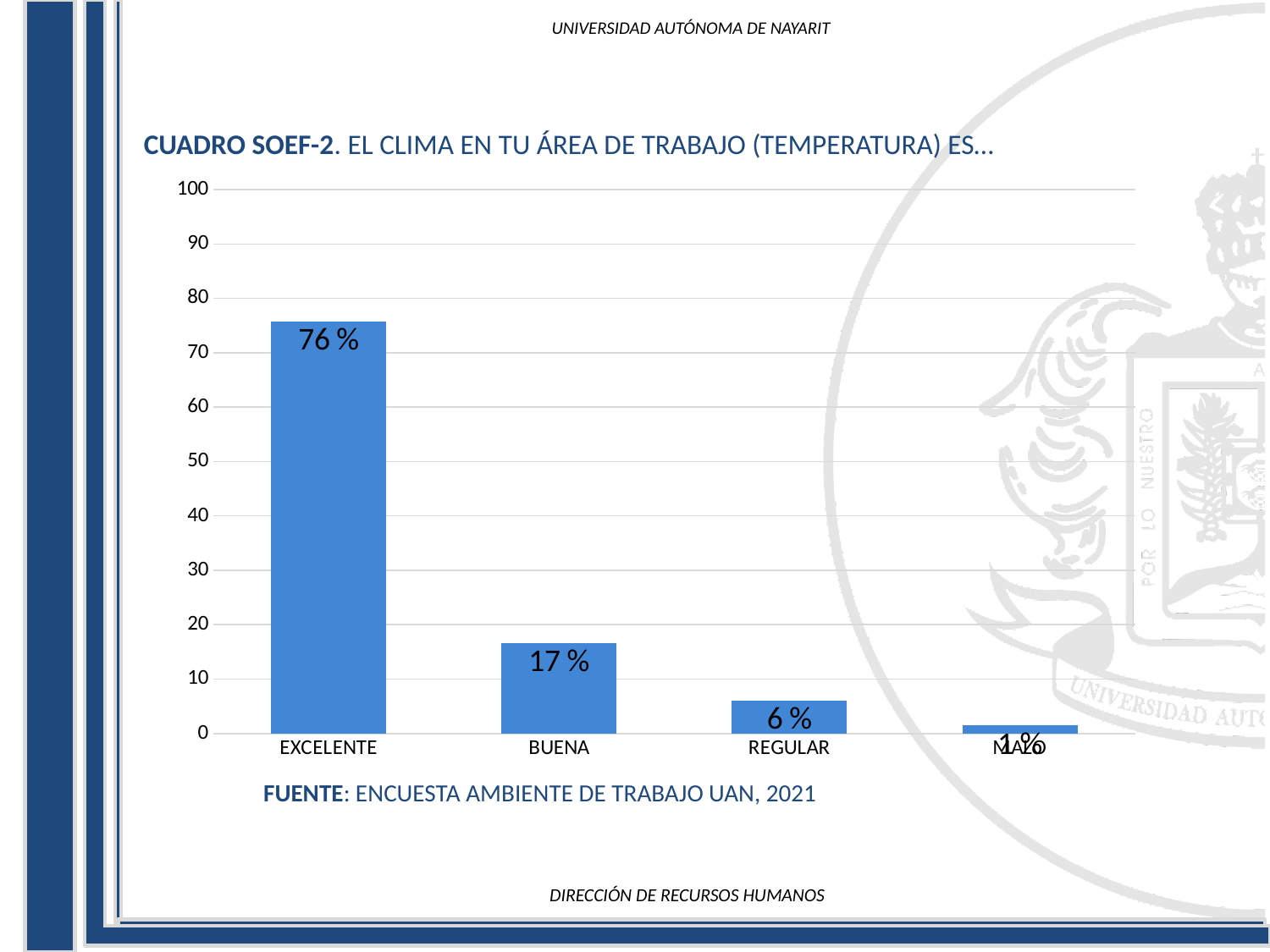
What is the value for EXCELENTE? 76 % Which category has the highest value? EXCELENTE How many categories are shown on the x axis? 4 Is the value for EXCELENTE greater or less than 70? greater What is the difference between the values for BUENA and REGULAR? 11 % What is the difference between the values for EXCELENTE and BUENA? 59 % What kind of chart is shown on the slide? bar chart Which is larger, the value for BUENA or the value for REGULAR? BUENA What source is cited below the chart? ENCUESTA AMBIENTE DE TRABAJO UAN, 2021 What is the value for BUENA? 17 % Do the values rise or fall from left to right along the x axis? fall What is the value for REGULAR? 6 %